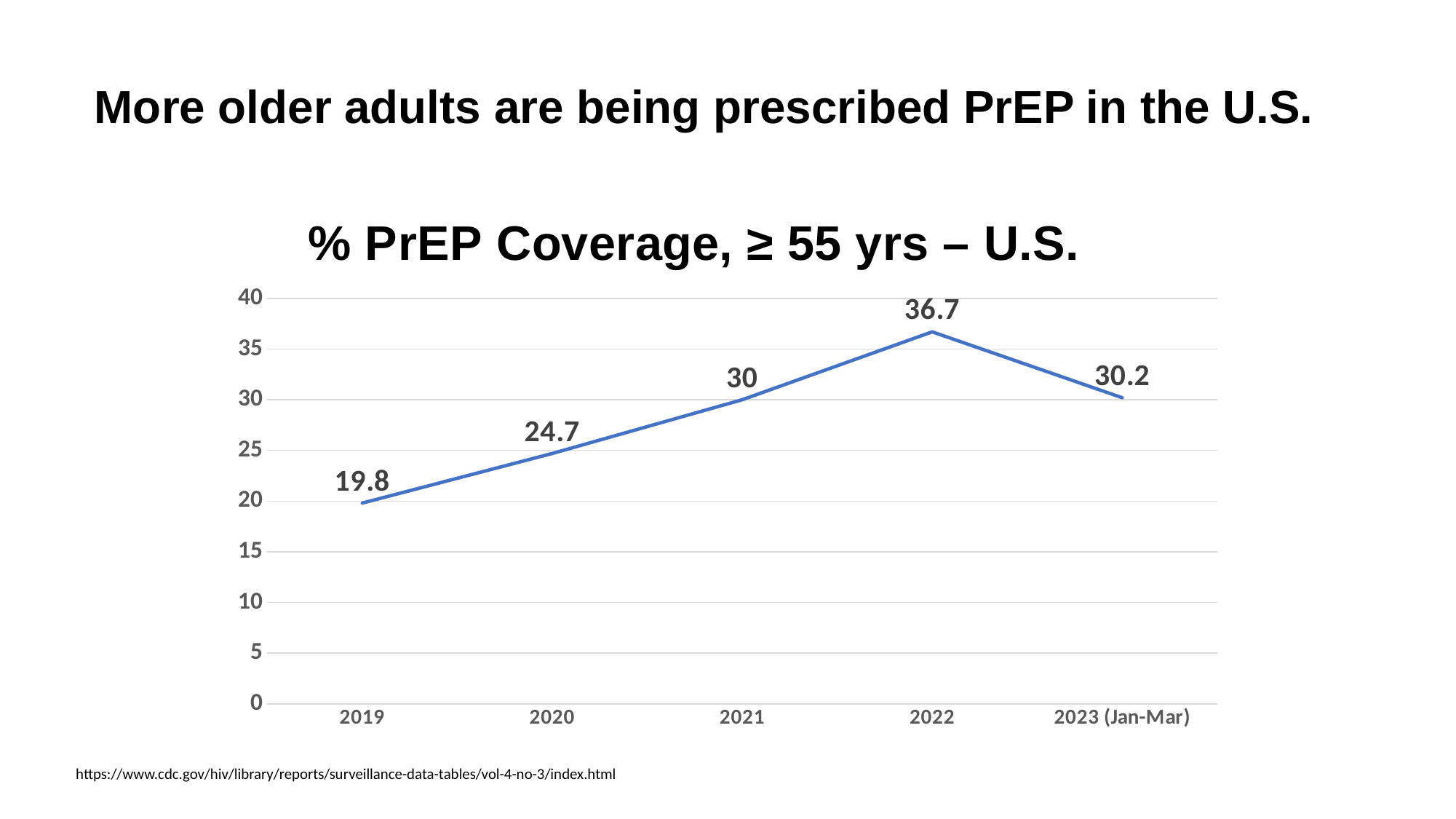
What is the title of the chart? % PrEP Coverage, ≥ 55 yrs – U.S. Which year has the highest % PrEP coverage? 2022 What is the % PrEP coverage for 2021? 30 Is the value for 2022 greater or less than 35? greater What is the % PrEP coverage for 2019? 19.8 What kind of chart is shown on the slide? Line chart Which has a higher % PrEP coverage, 2020 or 2022? 2022 What is the difference in % PrEP coverage between 2021 and 2020? 5.3 What is the difference in % PrEP coverage between 2022 and 2019? 16.9 How many time points are plotted on the chart? 5 Which year has the lowest % PrEP coverage? 2019 What is the % PrEP coverage for 2023 (Jan-Mar)? 30.2